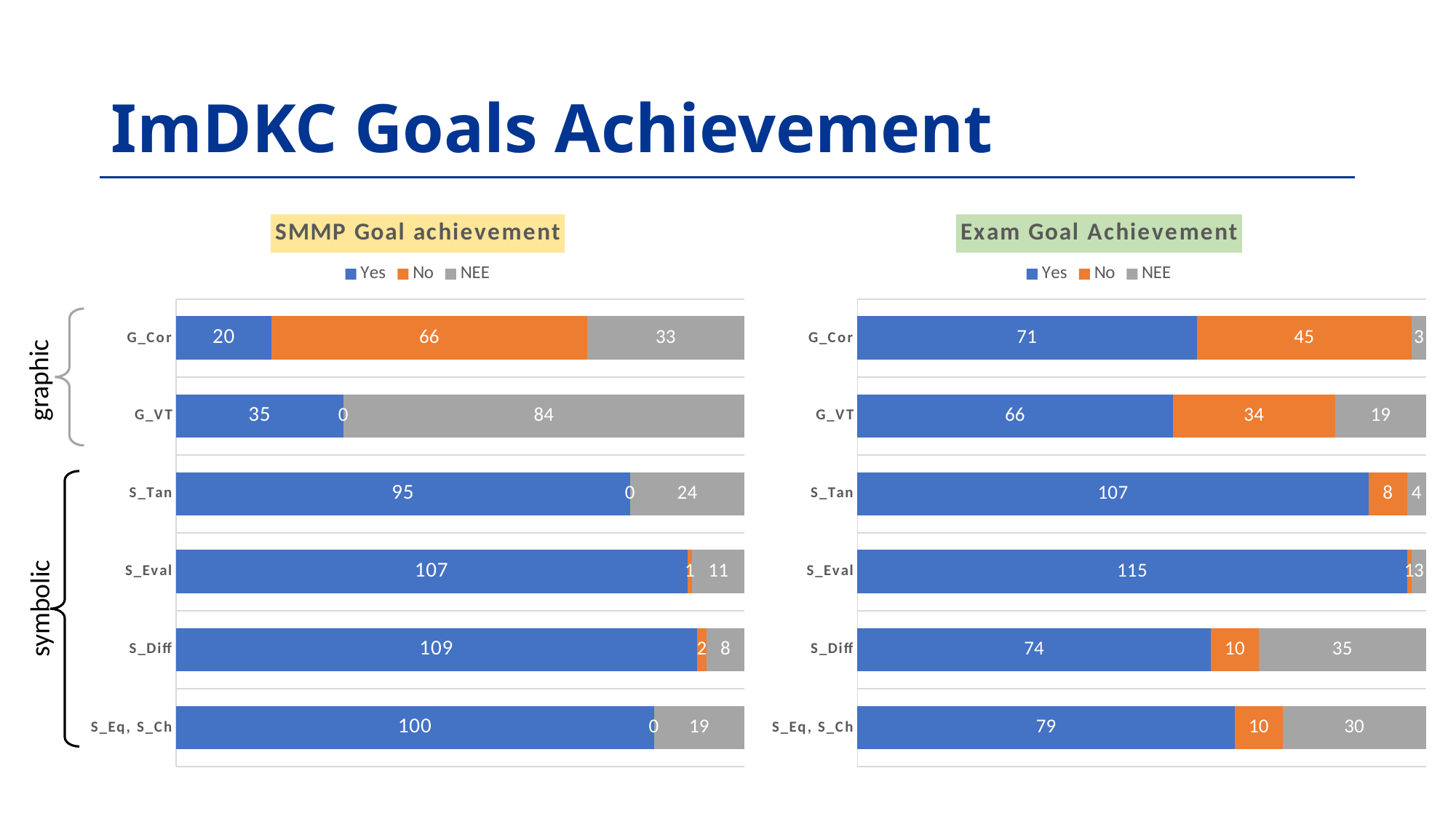
How many categories are shown in the Exam Goal Achievement chart? 6 In the Exam Goal Achievement chart, what is the difference between the Yes values for S_Tan and S_Diff? 33 In the SMMP Goal achievement chart, what is the total of the stacked bar for G_VT? 119 In the Exam Goal Achievement chart, which is larger: the No value for G_Cor or the No value for G_VT? G_Cor What type of chart is the Exam Goal Achievement chart? Stacked bar chart In the Exam Goal Achievement chart, what is the NEE value for S_Diff? 35 In the SMMP Goal achievement chart, which category has the highest Yes value? S_Diff How many series does the legend of the SMMP Goal achievement chart list? 3 In the SMMP Goal achievement chart, what is the No value for G_Cor? 66 In the SMMP Goal achievement chart, which category has the lowest Yes value? G_Cor In the SMMP Goal achievement chart, what is the Yes value for S_Diff? 109 In the Exam Goal Achievement chart, what is the Yes value for G_VT? 66